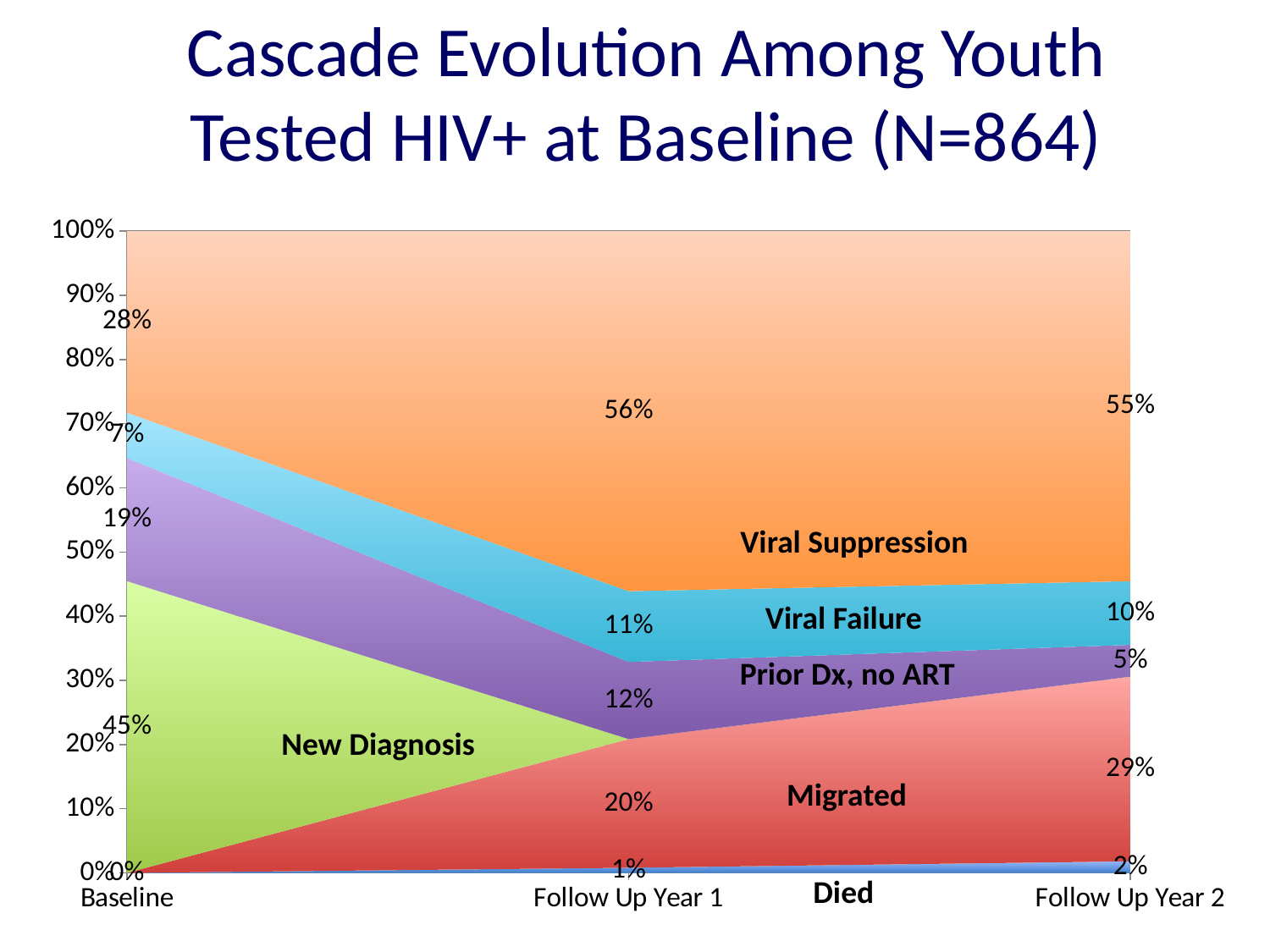
What is the difference between the Migrated value at Follow Up Year 2 and at Follow Up Year 1? 9% What is the Viral Suppression value at Follow Up Year 1? 56% What is the Prior Dx, no ART value at Follow Up Year 1? 12% What is the Migrated value at Follow Up Year 2? 29% How many time points are shown on the x axis? 3 At which time point is Viral Suppression highest? Follow Up Year 1 What is the Died value at Follow Up Year 2? 2% Does the Migrated value rise or fall from Baseline to Follow Up Year 2? Rise At which time point is Prior Dx, no ART lowest? Follow Up Year 2 What is the New Diagnosis value at Baseline? 45% What kind of chart is shown on the slide? Stacked area chart Which is larger at Follow Up Year 2: Viral Failure or Prior Dx, no ART? Viral Failure